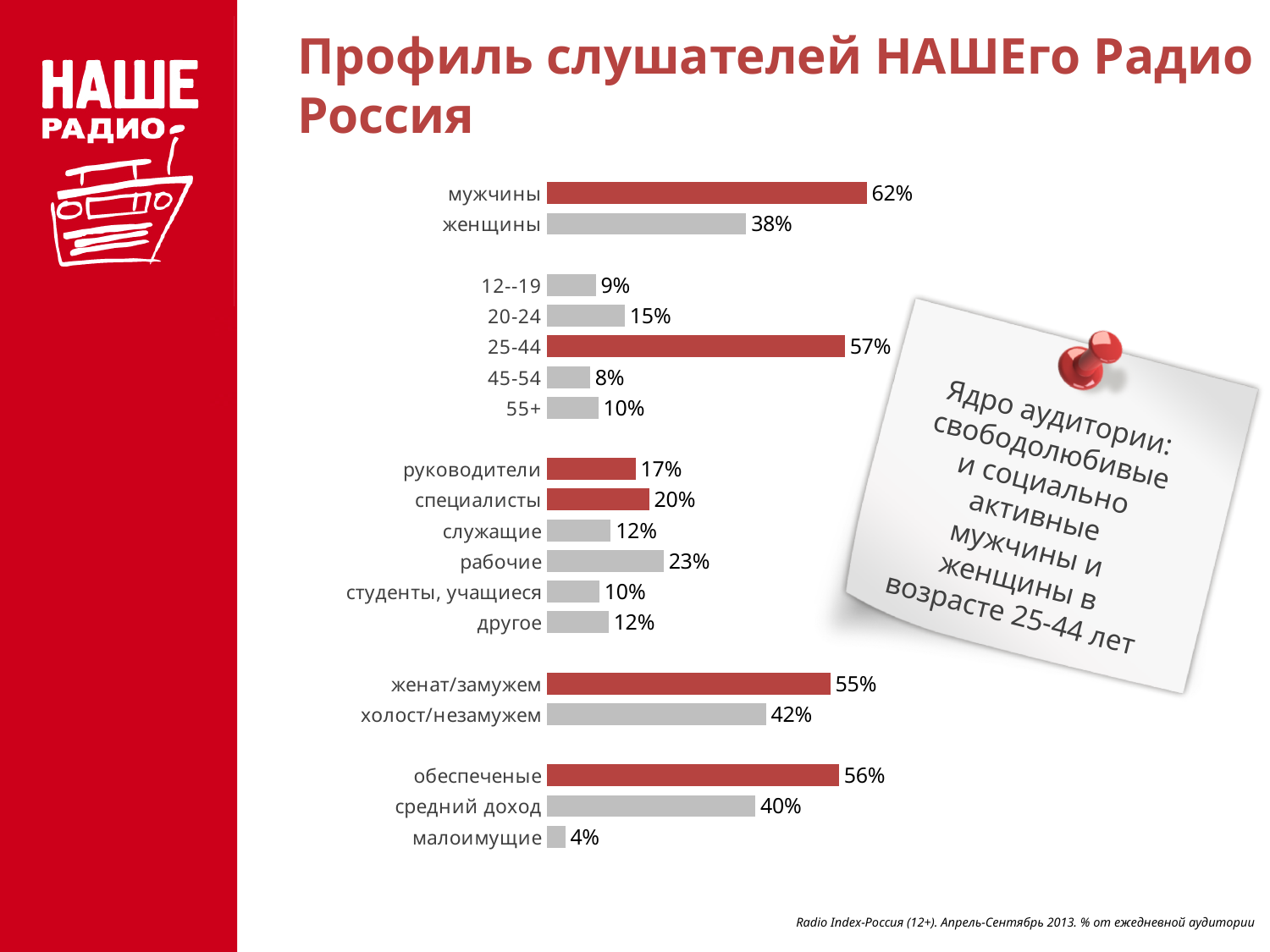
What is the value for the 25-44 age group? 57% What type of chart is shown on the slide? bar chart Which is larger, the value for специалисты or the value for руководители? специалисты What is the value for малоимущие? 4% What is the value for мужчины? 62% How many categories are plotted in the chart? 18 Which category has the highest value in the chart? мужчины What is the difference between the values for мужчины and женщины? 24% What is the value for рабочие? 23% Which age group has the lowest value? 45-54 What is the difference between the values for женат/замужем and холост/незамужем? 13% Which category has the lowest value in the chart? малоимущие